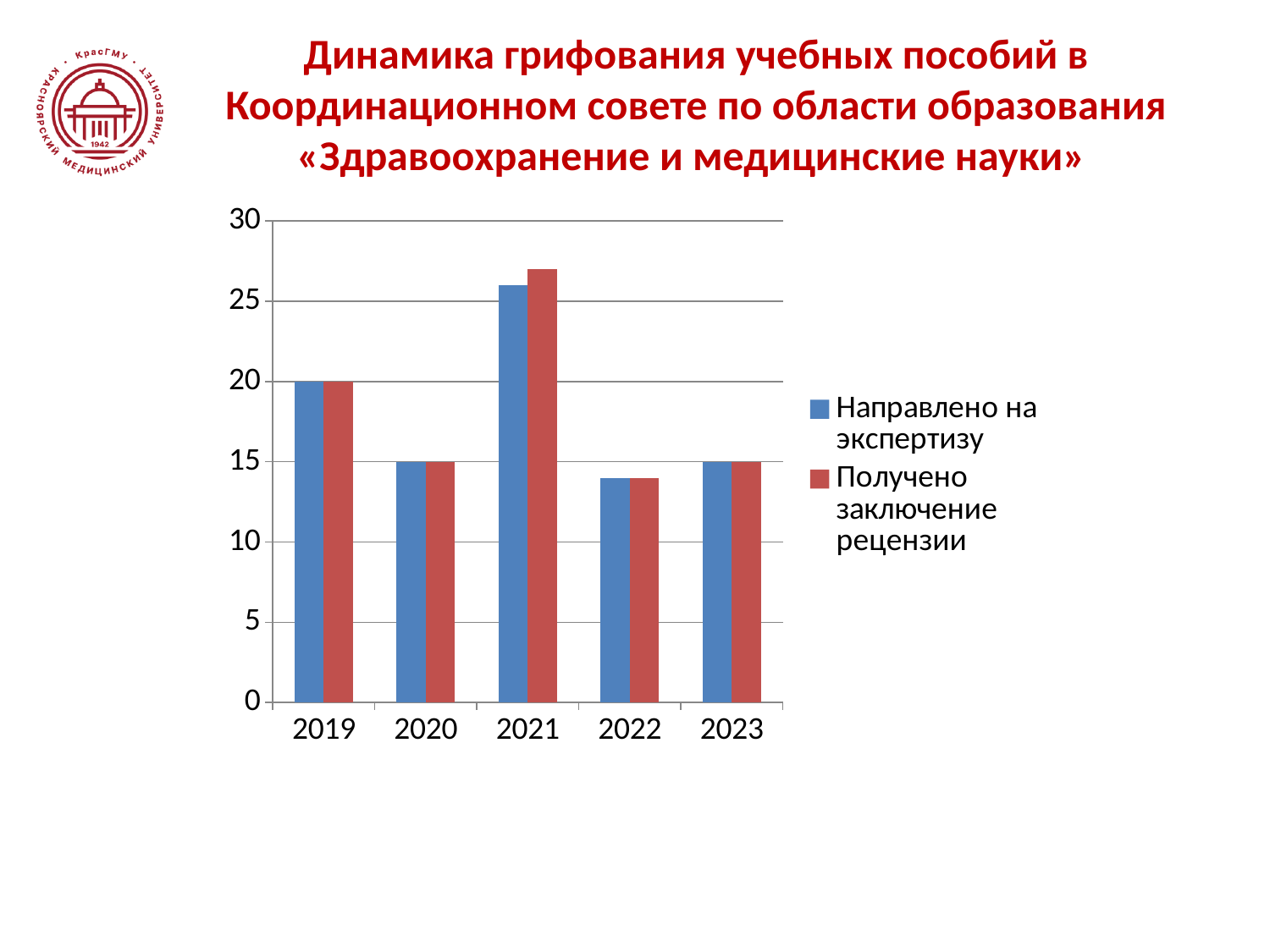
Is the value of «Направлено на экспертизу» for 2021 greater or less than 25? greater How many series does the legend list? 2 What is the value of «Направлено на экспертизу» for 2019? 20 What is the value of «Направлено на экспертизу» for 2023? 15 In which year is the value of «Получено заключение рецензии» lowest? 2022 Which year has the larger value of «Направлено на экспертизу», 2019 or 2021? 2021 By how much does «Направлено на экспертизу» in 2019 exceed the value in 2020? 5 What kind of chart is shown on the slide? bar chart What is the value of «Получено заключение рецензии» for 2020? 15 In which year is the value of «Направлено на экспертизу» highest? 2021 Is the value of «Получено заключение рецензии» for 2022 greater or less than 15? less How many years are shown on the x axis? 5